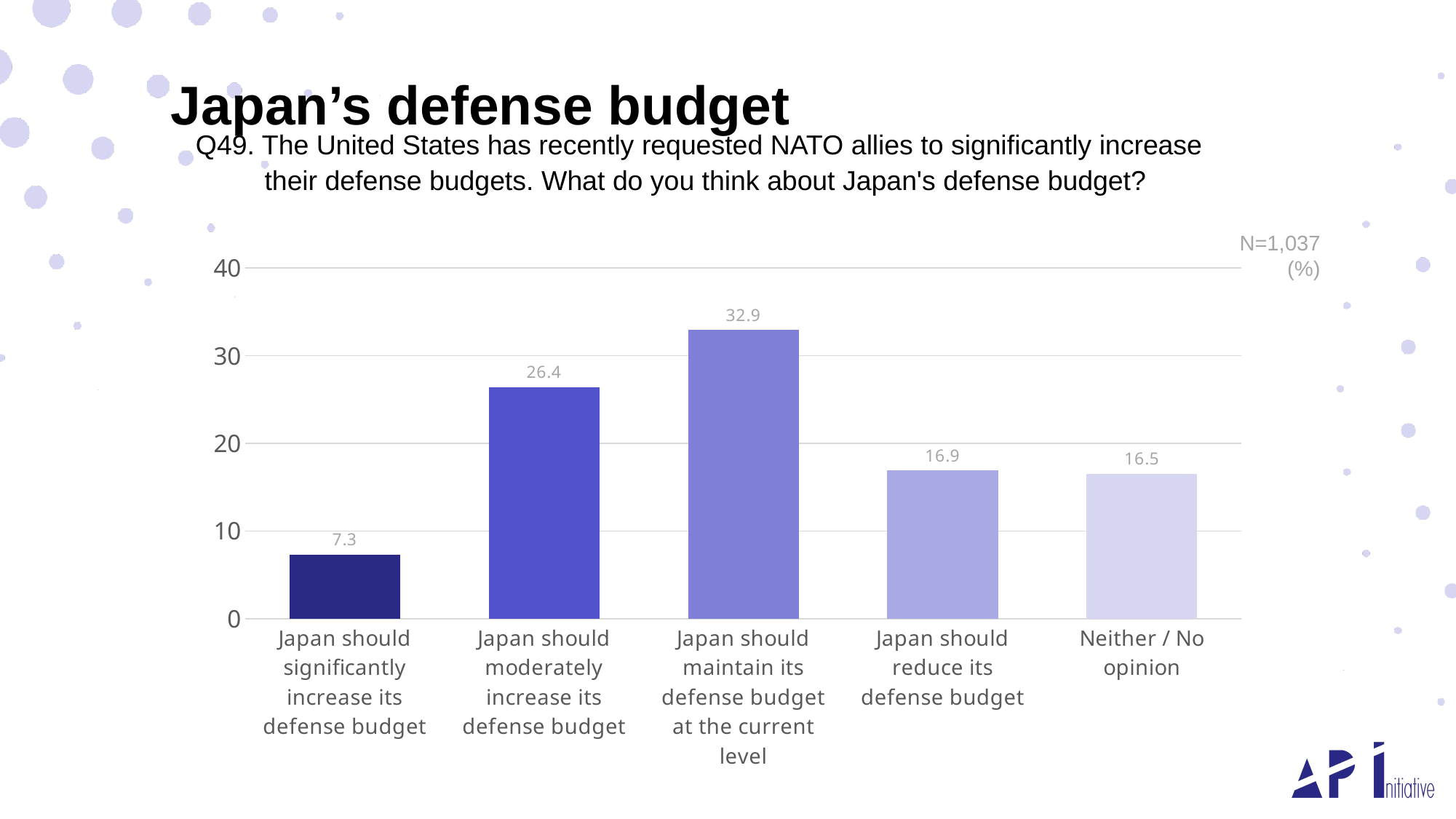
What is the value for "Japan should maintain its defense budget at the current level"? 32.9 What is the value for "Neither / No opinion"? 16.5 Is the value for "Japan should moderately increase its defense budget" greater or less than 30? less What is the difference between the values for "Japan should maintain its defense budget at the current level" and "Japan should moderately increase its defense budget"? 6.5 What is the sample size (N) shown on the chart? N=1,037 Which category has the lowest value? Japan should significantly increase its defense budget What kind of chart is shown on the slide? Bar chart Which is larger: the value for "Japan should moderately increase its defense budget" or "Japan should reduce its defense budget"? Japan should moderately increase its defense budget What is the value for "Japan should significantly increase its defense budget"? 7.3 How many categories are shown on the chart? 5 What is the difference between the values for "Japan should reduce its defense budget" and "Neither / No opinion"? 0.4 Which category has the highest value? Japan should maintain its defense budget at the current level